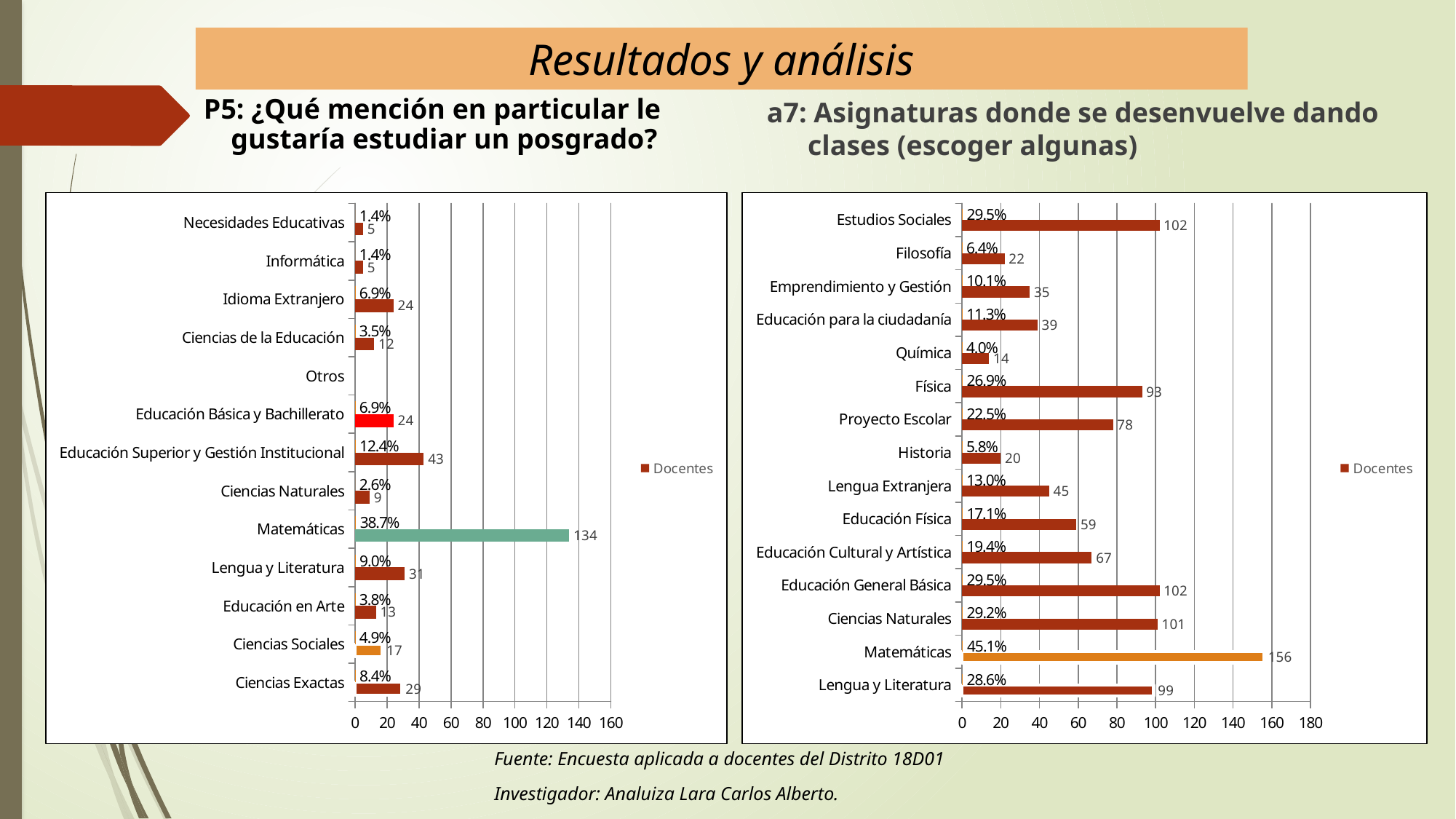
In the P5 chart (left), how many docentes chose Matemáticas? 134 What type of chart is the a7 chart (right)? Bar chart In the P5 chart (left), which category has the highest value? Matemáticas In the P5 chart (left), what percentage is shown for Educación Superior y Gestión Institucional? 12.4% In the a7 chart (right), how many series does the legend list? 1 In the a7 chart (right), what is the difference between the values for Matemáticas and Estudios Sociales? 54 In the a7 chart (right), which category has the lowest value? Química In the P5 chart (left), how many categories are listed on the vertical axis? 13 In the a7 chart (right), what percentage is shown for Matemáticas? 45.1% In the P5 chart (left), what is the difference between the values for Lengua y Literatura and Ciencias Exactas? 2 In the a7 chart (right), how many docentes are shown for Física? 93 In the P5 chart (left), which is larger, the value for Idioma Extranjero or the value for Ciencias de la Educación? Idioma Extranjero